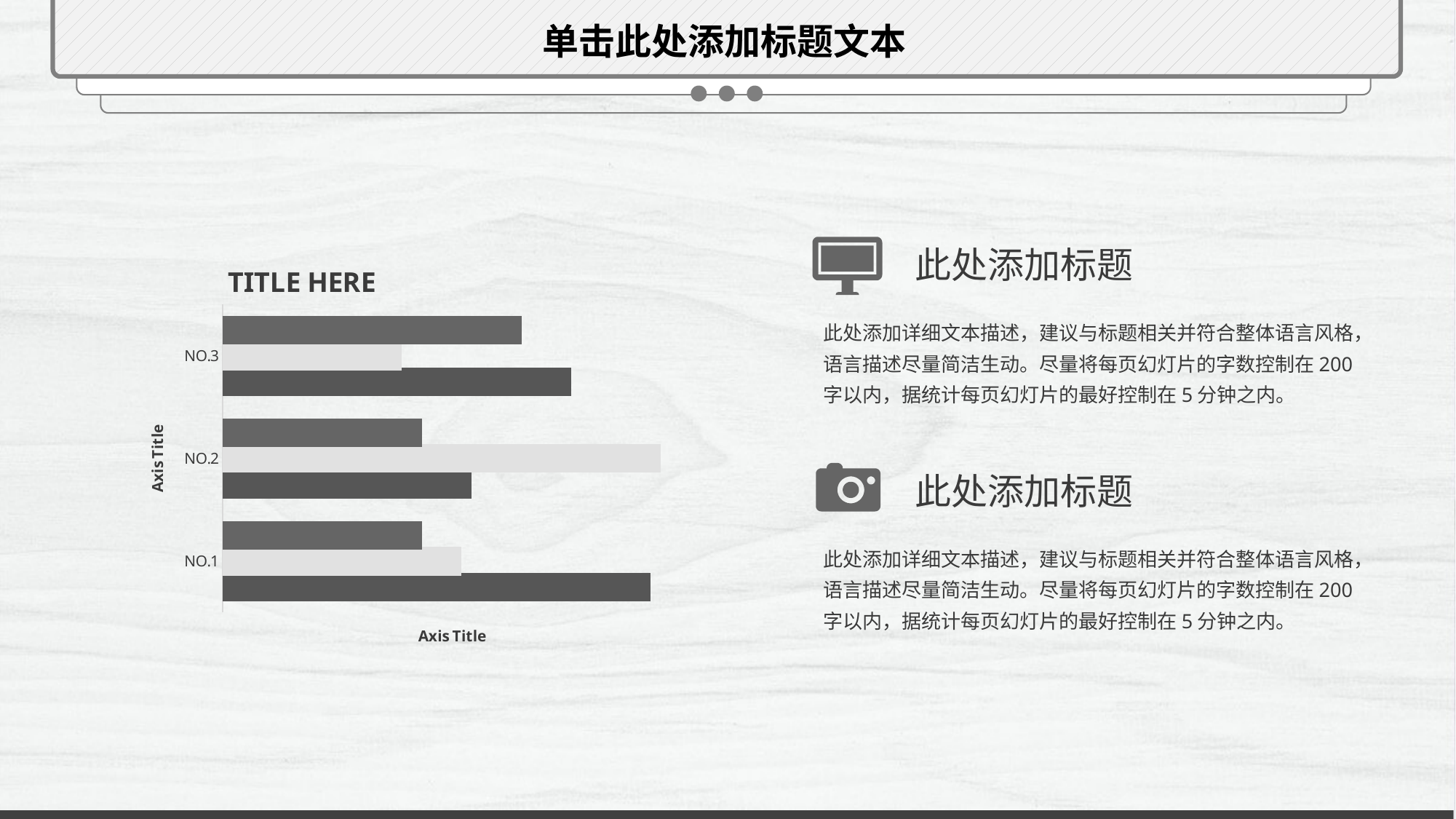
Are the bars in the chart drawn horizontally or vertically? Horizontally Among the light grey bars, which category has the shortest one? NO.3 Among the light grey bars, which category has the longest one? NO.2 What kind of chart is shown on the slide? Bar chart Among the top dark grey bars, which category has the longest one? NO.3 What is the label on the horizontal axis of the chart? Axis Title For category NO.2, which of the three bars is the longest? The light grey (middle) bar How many categories are shown on the vertical axis of the chart? 3 For category NO.3, is the light grey bar longer or shorter than the top dark grey bar? Shorter Among the bottom dark grey bars, which category has the shortest one? NO.2 For category NO.1, which of the three bars is the longest? The bottom dark grey bar What is the title of the chart? TITLE HERE